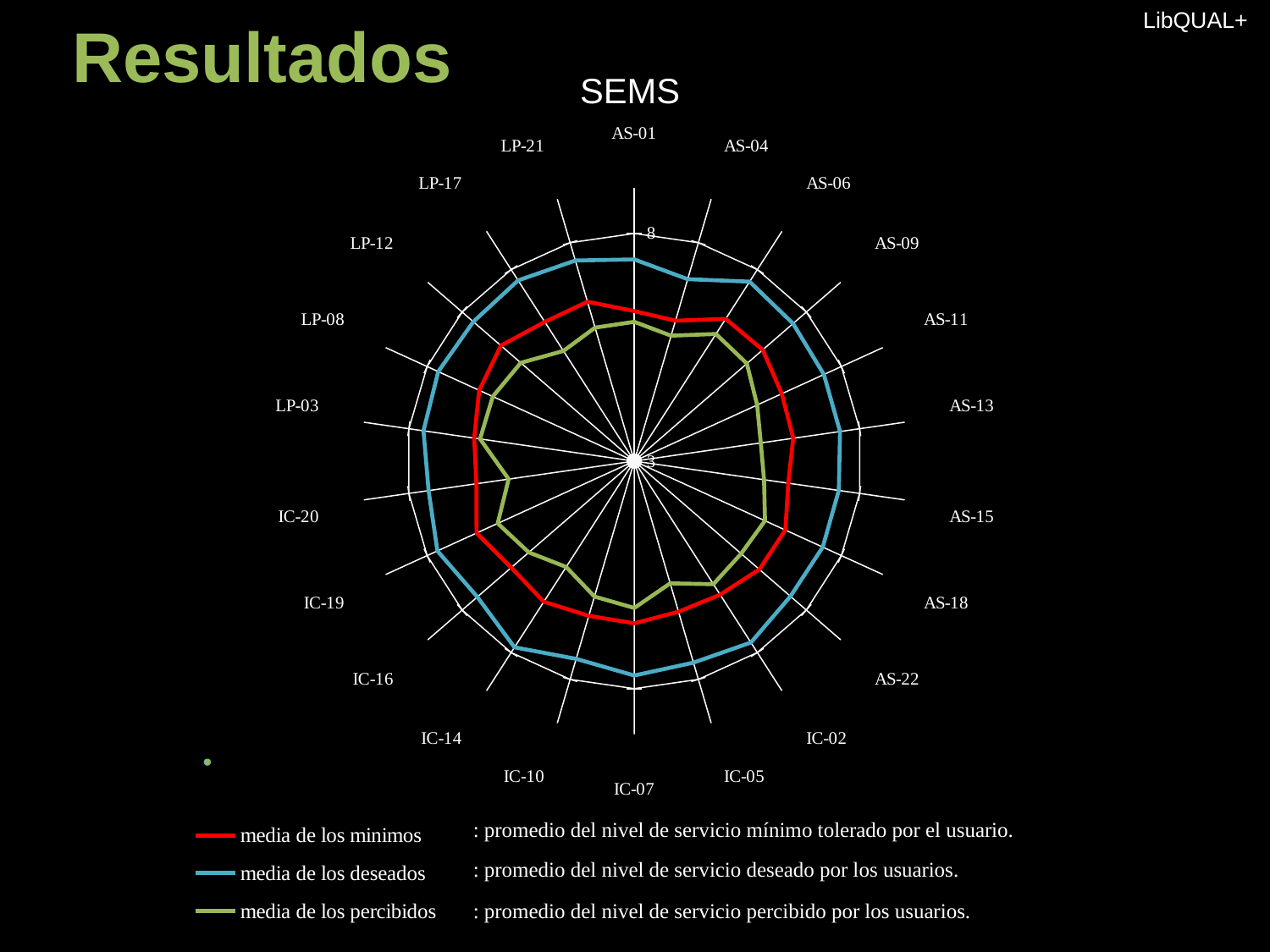
Which colour is used for the 'media de los deseados' series? blue Which series forms the outermost line on the radar chart? media de los deseados How many categories (axes) does the radar chart have? 22 Which series forms the innermost line on the radar chart? media de los percibidos What kind of chart is shown on the slide? radar chart How many series does the legend list for the chart? 3 What is the title of the chart? SEMS Is the value of 'media de los deseados' for AS-01 greater or less than 8? less For LP-03, which series has the larger value: 'media de los deseados' or 'media de los minimos'? media de los deseados Is the value of 'media de los percibidos' for AS-13 greater or less than 8? less For AS-01, which series has the larger value: 'media de los deseados' or 'media de los percibidos'? media de los deseados For IC-07, which series has the larger value: 'media de los minimos' or 'media de los percibidos'? media de los minimos